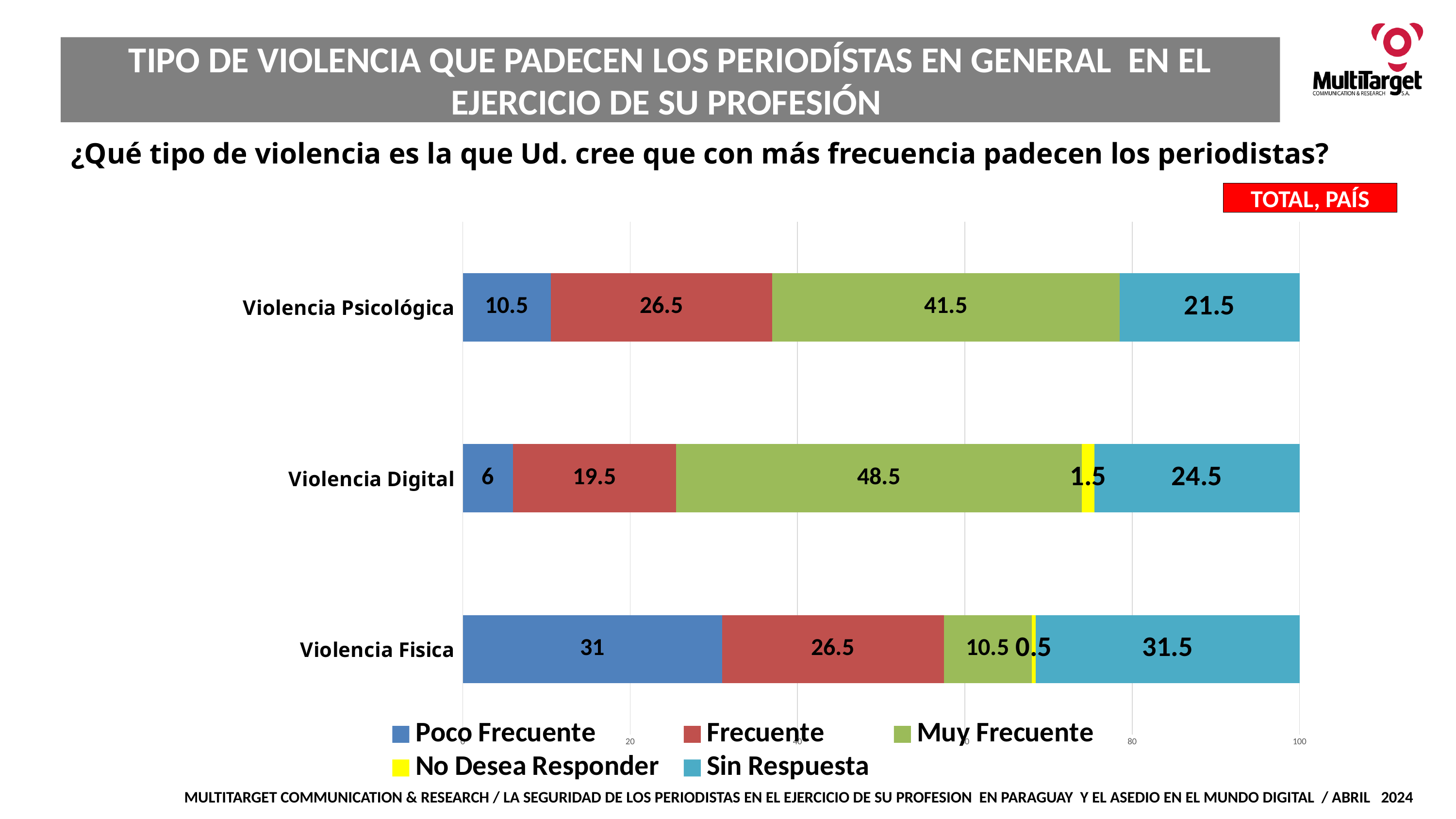
What is the Poco Frecuente value for Violencia Fisica? 31 How many series does the legend list? 5 How many categories are shown on the chart? 3 What is the total of the stacked bar for Violencia Fisica? 100 Which category has the highest Muy Frecuente value? Violencia Digital What is the Muy Frecuente value for Violencia Digital? 48.5 Which category has the lowest Poco Frecuente value? Violencia Digital What is the Sin Respuesta value for Violencia Psicológica? 21.5 Which is larger, the Sin Respuesta value for Violencia Fisica or for Violencia Digital? Violencia Fisica What kind of chart is shown on the slide? Stacked bar chart What is the difference between the Muy Frecuente values for Violencia Digital and Violencia Fisica? 38 What is the No Desea Responder value for Violencia Digital? 1.5